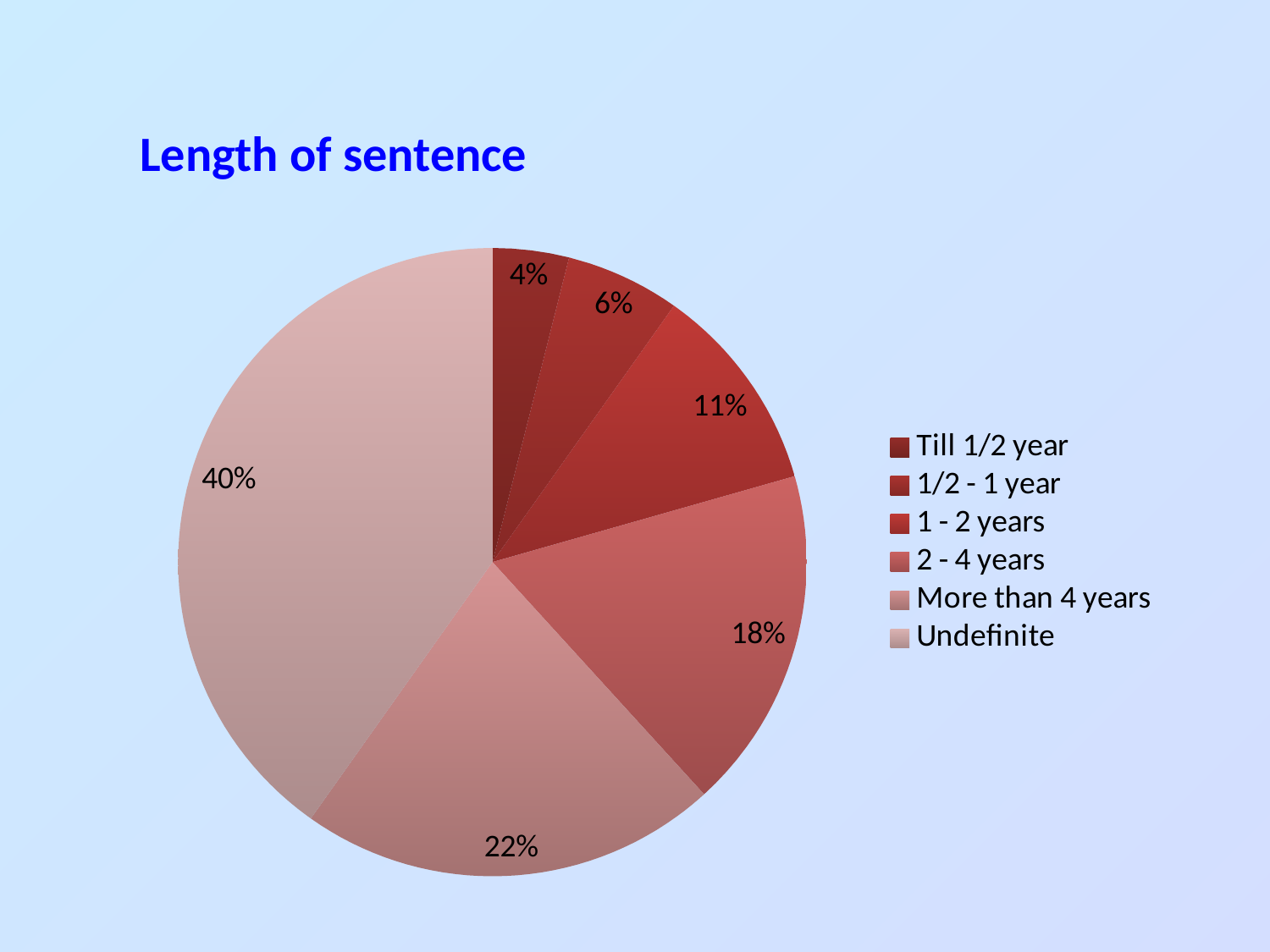
How many categories does the legend list? 6 What share of the pie is labelled for '1 - 2 years'? 11% What share of the pie is labelled for 'Undefinite'? 40% What share of the pie is labelled for 'Till 1/2 year'? 4% What kind of chart is shown on the slide? pie chart What is the title of the chart? Length of sentence What is the difference in percentage points between 'Undefinite' and 'More than 4 years'? 18 Which category has the largest slice of the pie? Undefinite Which category has the smallest slice of the pie? Till 1/2 year Which is larger, the slice for '1/2 - 1 year' or the slice for '1 - 2 years'? 1 - 2 years